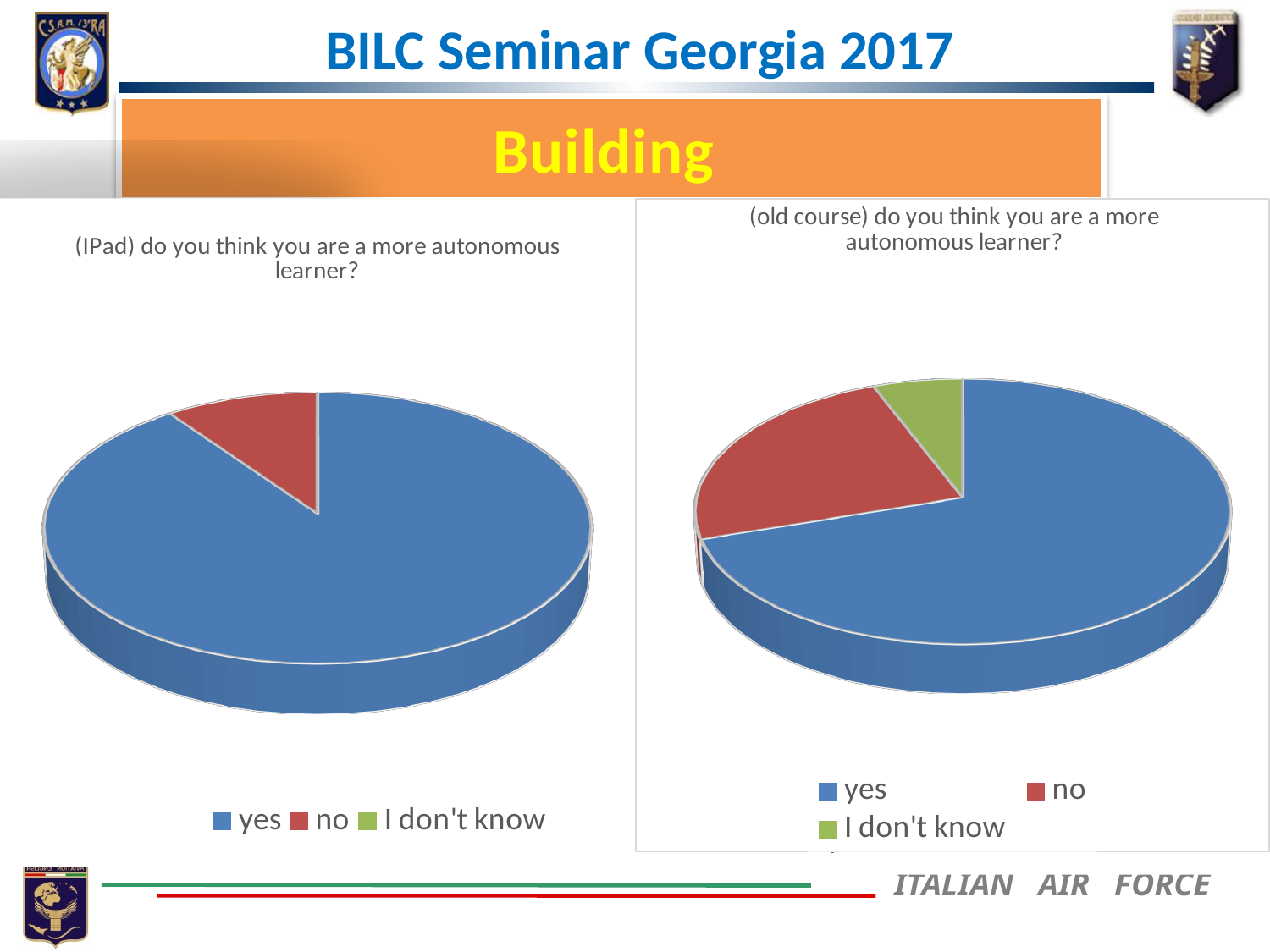
How many entries does the legend of the right chart (old course) list? 3 In the right chart (old course), what colour represents the "I don't know" response? green In the left chart (IPad), which response has the largest share of the pie? yes What kind of chart is the right chart titled "(old course) do you think you are a more autonomous learner?"? pie chart In the left chart (IPad), which is larger: the share for "yes" or the share for "no"? yes What kind of chart is the left chart titled "(IPad) do you think you are a more autonomous learner?"? pie chart In the right chart (old course), which is larger: the share for "no" or the share for "I don't know"? no What is the title of the left chart? (IPad) do you think you are a more autonomous learner? In the right chart (old course), which response has the largest share of the pie? yes How many entries does the legend of the left chart (IPad) list? 3 In the right chart (old course), which response has the smallest share of the pie? I don't know